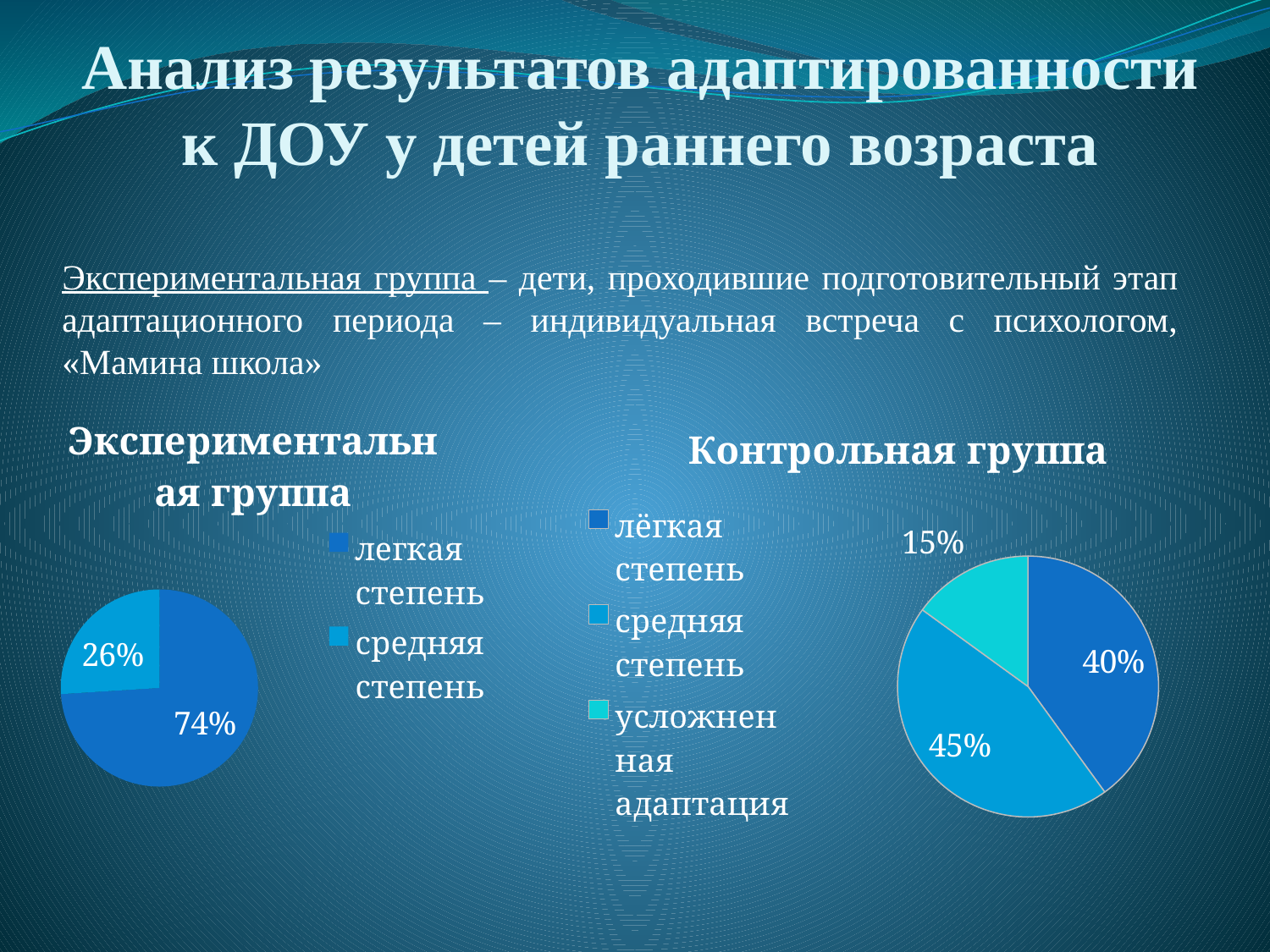
In the "Экспериментальная группа" chart, what share is labelled for "средняя степень"? 26% How many slices does the "Контрольная группа" pie chart have? 3 How many entries does the legend of the "Экспериментальная группа" chart list? 2 In the "Контрольная группа" chart, which is larger: "лёгкая степень" or "средняя степень"? средняя степень In the "Контрольная группа" chart, what share is labelled for "средняя степень"? 45% What kind of chart is the "Экспериментальная группа" chart? pie chart Which chart shows a larger share for "лёгкая степень": "Экспериментальная группа" or "Контрольная группа"? Экспериментальная группа In the "Экспериментальная группа" chart, what is the difference between the "легкая степень" and "средняя степень" shares? 48% In the "Контрольная группа" chart, which category has the smallest slice? усложненная адаптация In the "Экспериментальная группа" chart, which category has the largest slice? легкая степень In the "Контрольная группа" chart, what share is labelled for "усложненная адаптация"? 15% In the "Экспериментальная группа" chart, what share is labelled for "легкая степень"? 74%